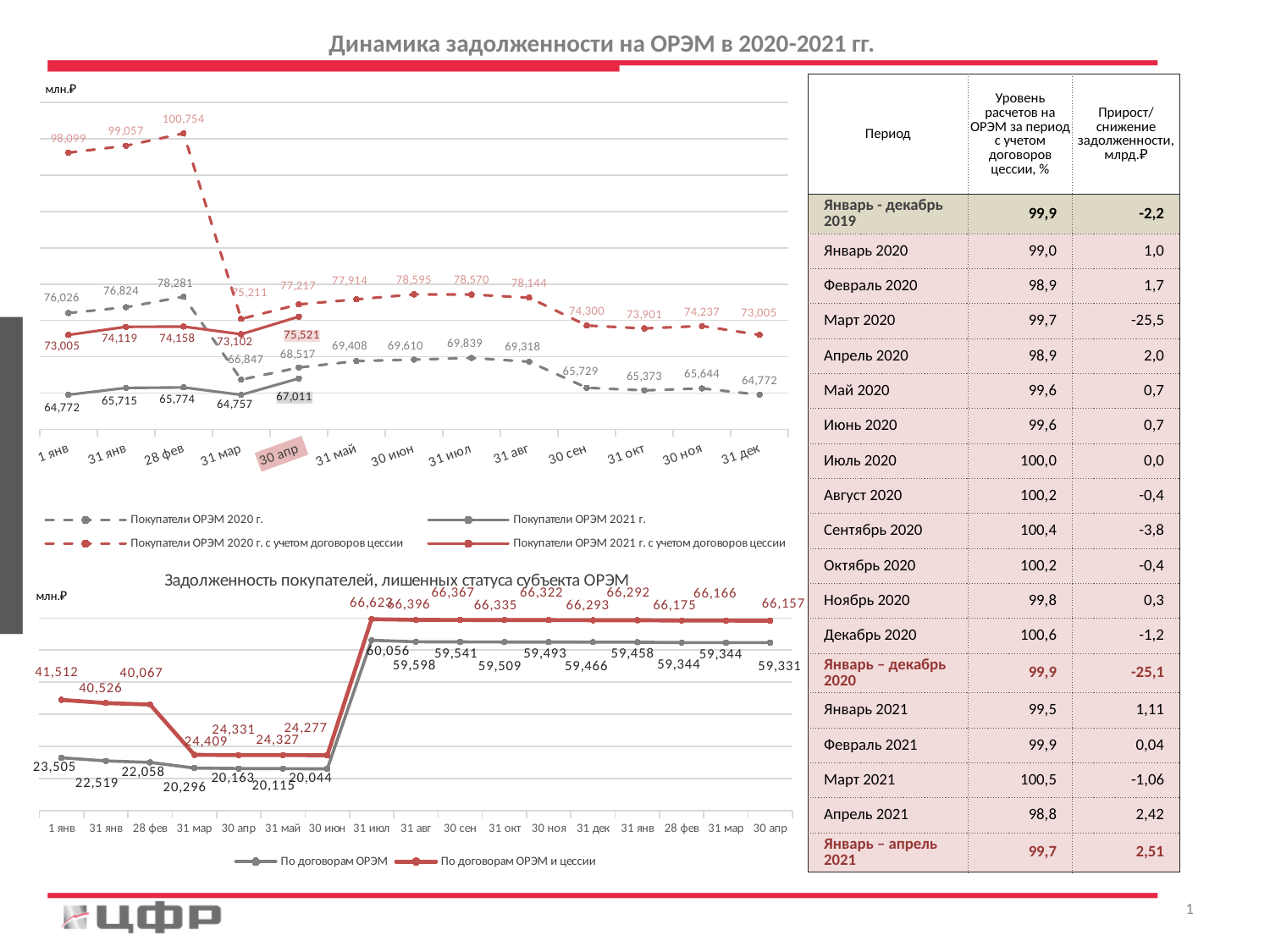
How many series does the legend of the top chart list? 4 How many x-axis points does the top chart have? 13 What type of chart is the bottom chart 'Задолженность покупателей, лишенных статуса субъекта ОРЭМ'? Line chart In the bottom chart 'Задолженность покупателей, лишенных статуса субъекта ОРЭМ', what is the value for 'По договорам ОРЭМ и цессии' at 31 июл? 66,623 In the top chart, at which x-axis point does the 'Покупатели ОРЭМ 2020 г. с учетом договоров цессии' series reach its highest value? 28 фев In the top chart, what is the value for 'Покупатели ОРЭМ 2020 г.' at 31 дек? 64,772 In the top chart, what is the value for 'Покупатели ОРЭМ 2021 г.' at 30 апр? 67,011 In the bottom chart 'Задолженность покупателей, лишенных статуса субъекта ОРЭМ', which series has the larger value at 30 апр (last point): 'По договорам ОРЭМ' or 'По договорам ОРЭМ и цессии'? По договорам ОРЭМ и цессии In the top chart, what is the value for 'Покупатели ОРЭМ 2020 г. с учетом договоров цессии' at 28 фев? 100,754 In the bottom chart 'Задолженность покупателей, лишенных статуса субъекта ОРЭМ', what is the value for 'По договорам ОРЭМ' at 1 янв? 23,505 In the top chart, at which x-axis point is the 'Покупатели ОРЭМ 2021 г.' series lowest? 31 мар In the top chart, what is the difference between 'Покупатели ОРЭМ 2021 г. с учетом договоров цессии' and 'Покупатели ОРЭМ 2021 г.' at 30 апр? 8,510